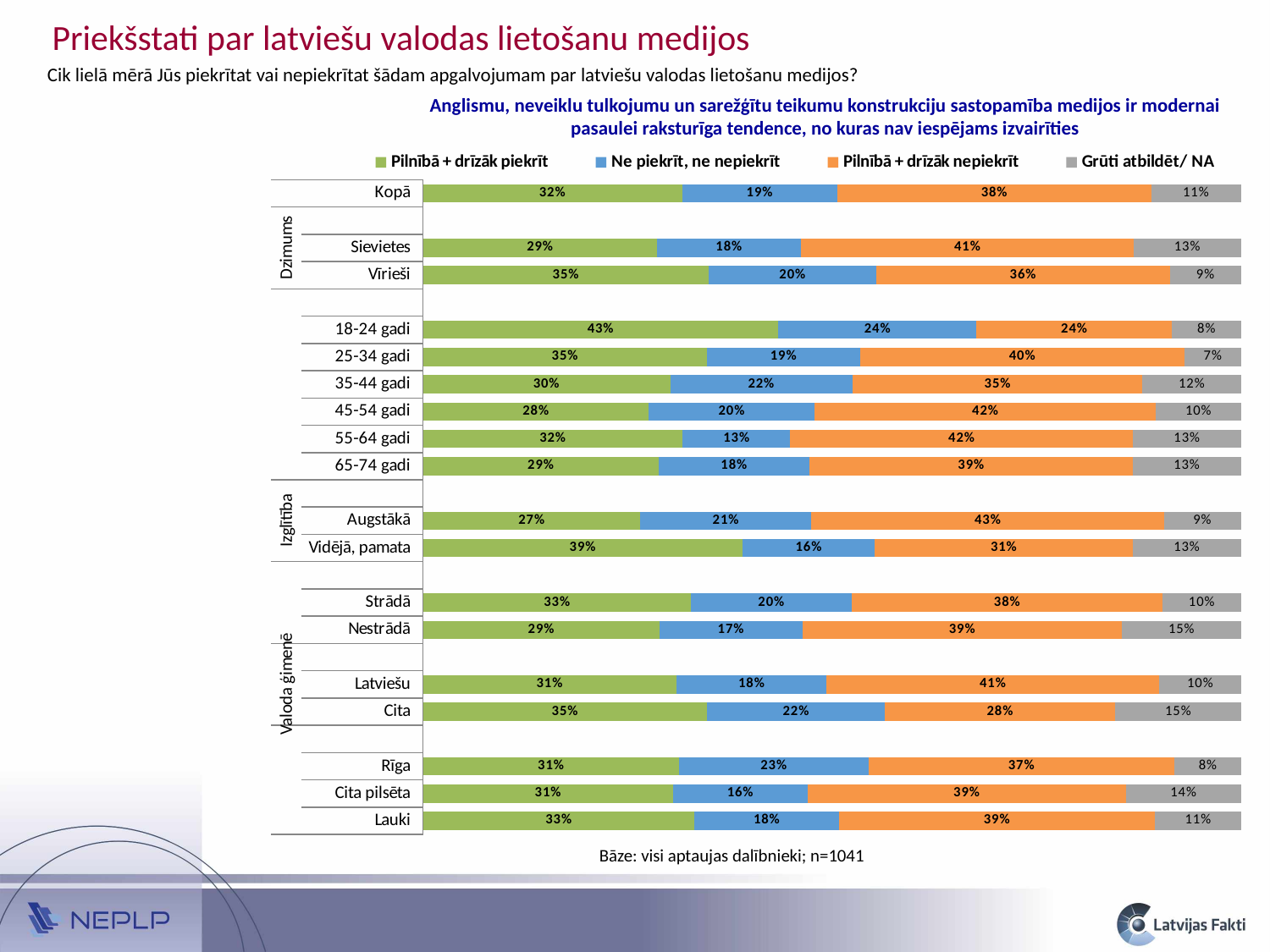
What is the difference between "Pilnībā + drīzāk nepiekrīt" and "Pilnībā + drīzāk piekrīt" for Kopā? 6 percentage points Which category has the highest value for "Pilnībā + drīzāk piekrīt"? 18-24 gadi Which category has the lowest value for "Grūti atbildēt/ NA"? 25-34 gadi How many series does the legend list? 4 What is the value of "Grūti atbildēt/ NA" for Nestrādā? 15% What is the value of "Pilnībā + drīzāk piekrīt" for Kopā? 32% Which is larger for "Pilnībā + drīzāk piekrīt": Sievietes or Vīrieši? Vīrieši What is the total of the stacked bar for Kopā? 100% What is the value of "Ne piekrīt, ne nepiekrīt" for Rīga? 23% What is the value of "Pilnībā + drīzāk nepiekrīt" for Sievietes? 41% What type of chart is shown on the slide? Stacked bar chart Which category has the lowest value for "Pilnībā + drīzāk piekrīt"? Augstākā